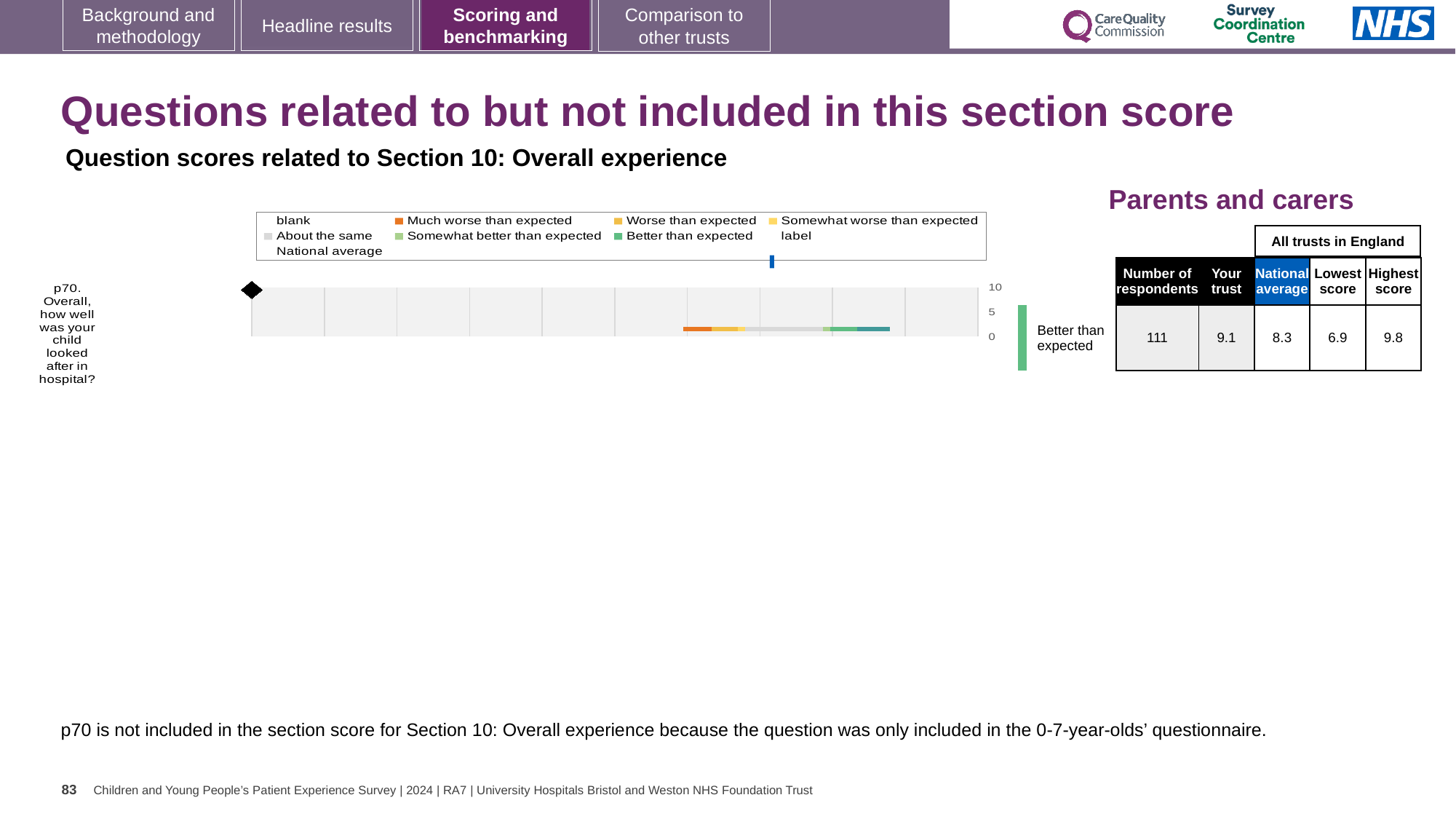
What rating is shown next to the bar for p70? Better than expected How many respondents answered p70? 111 Which is higher for p70: the 'Your trust' score or the national average? Your trust What is the lowest score among all trusts in England for p70? 6.9 What kind of chart is used to show the p70 question score? bar chart What is the difference between the highest score and the lowest score for p70? 2.9 Is the 'Your trust' score for p70 greater or less than 5? greater What is the highest score among all trusts in England for p70? 9.8 What is the national average score for p70? 8.3 Which question is plotted in the chart? p70. Overall, how well was your child looked after in hospital? How many survey questions are plotted in the chart? 1 What is the 'Your trust' score for p70? 9.1